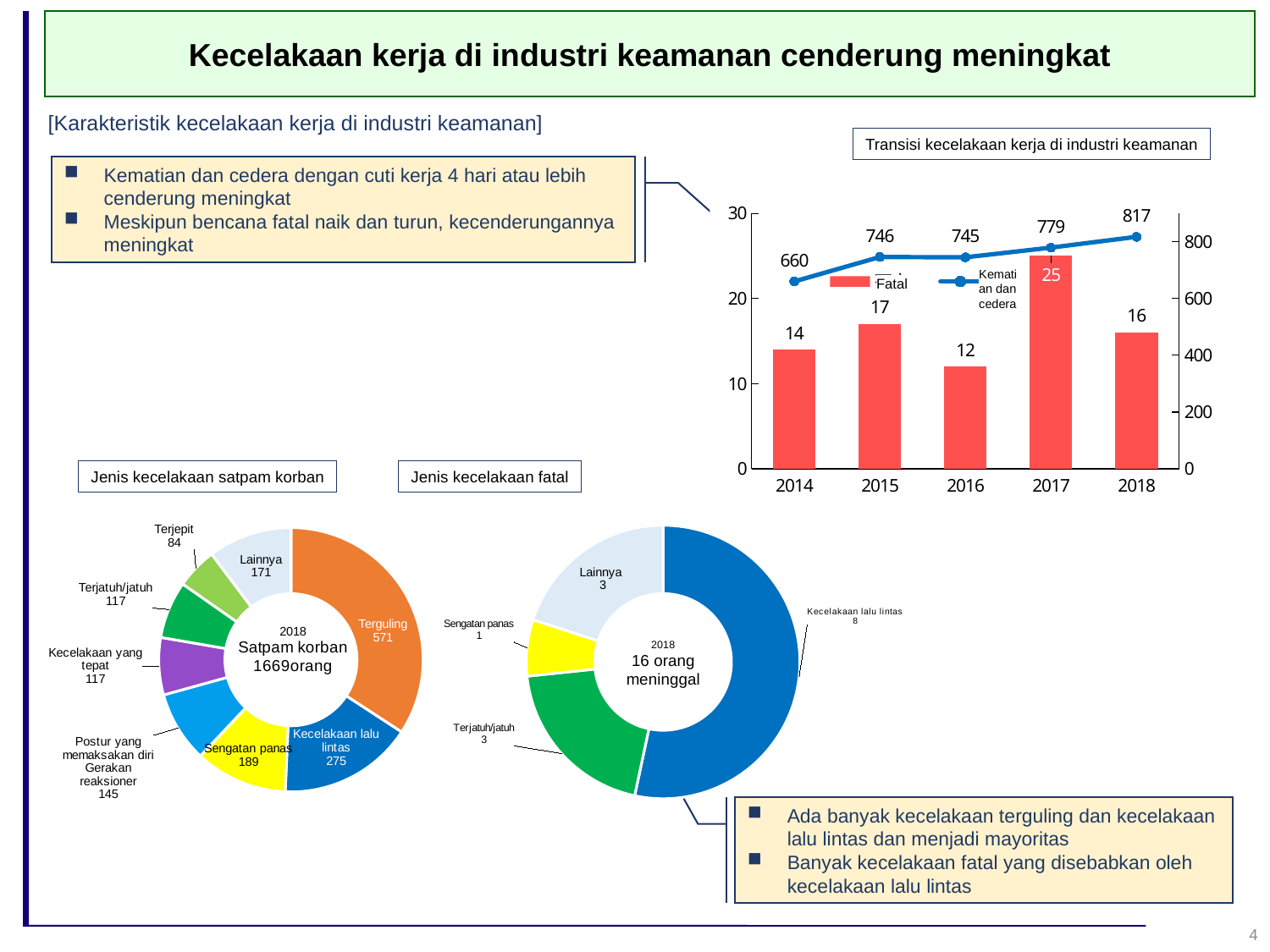
In the chart 'Jenis kecelakaan satpam korban', which is larger: Sengatan panas or Kecelakaan lalu lintas? Kecelakaan lalu lintas How many years are shown on the x axis of the chart 'Transisi kecelakaan kerja di industri keamanan'? 5 In the chart 'Transisi kecelakaan kerja di industri keamanan', which year has the lowest Fatal value? 2016 In the chart 'Jenis kecelakaan satpam korban', which category has the largest value? Terguling In the chart 'Jenis kecelakaan satpam korban', what is the value for Terguling? 571 In the chart 'Transisi kecelakaan kerja di industri keamanan', does the 'Kematian dan cedera' line generally rise or fall from 2014 to 2018? rise In the chart 'Transisi kecelakaan kerja di industri keamanan', what is the Fatal value for 2017? 25 In the chart 'Transisi kecelakaan kerja di industri keamanan', what is the difference between the Fatal values for 2017 and 2016? 13 In the chart 'Jenis kecelakaan fatal', what is the value for Kecelakaan lalu lintas? 8 In the chart 'Transisi kecelakaan kerja di industri keamanan', what is the 'Kematian dan cedera' value for 2018? 817 What type of chart is 'Jenis kecelakaan fatal'? donut (pie) chart How many series does the legend of the chart 'Transisi kecelakaan kerja di industri keamanan' list? 2